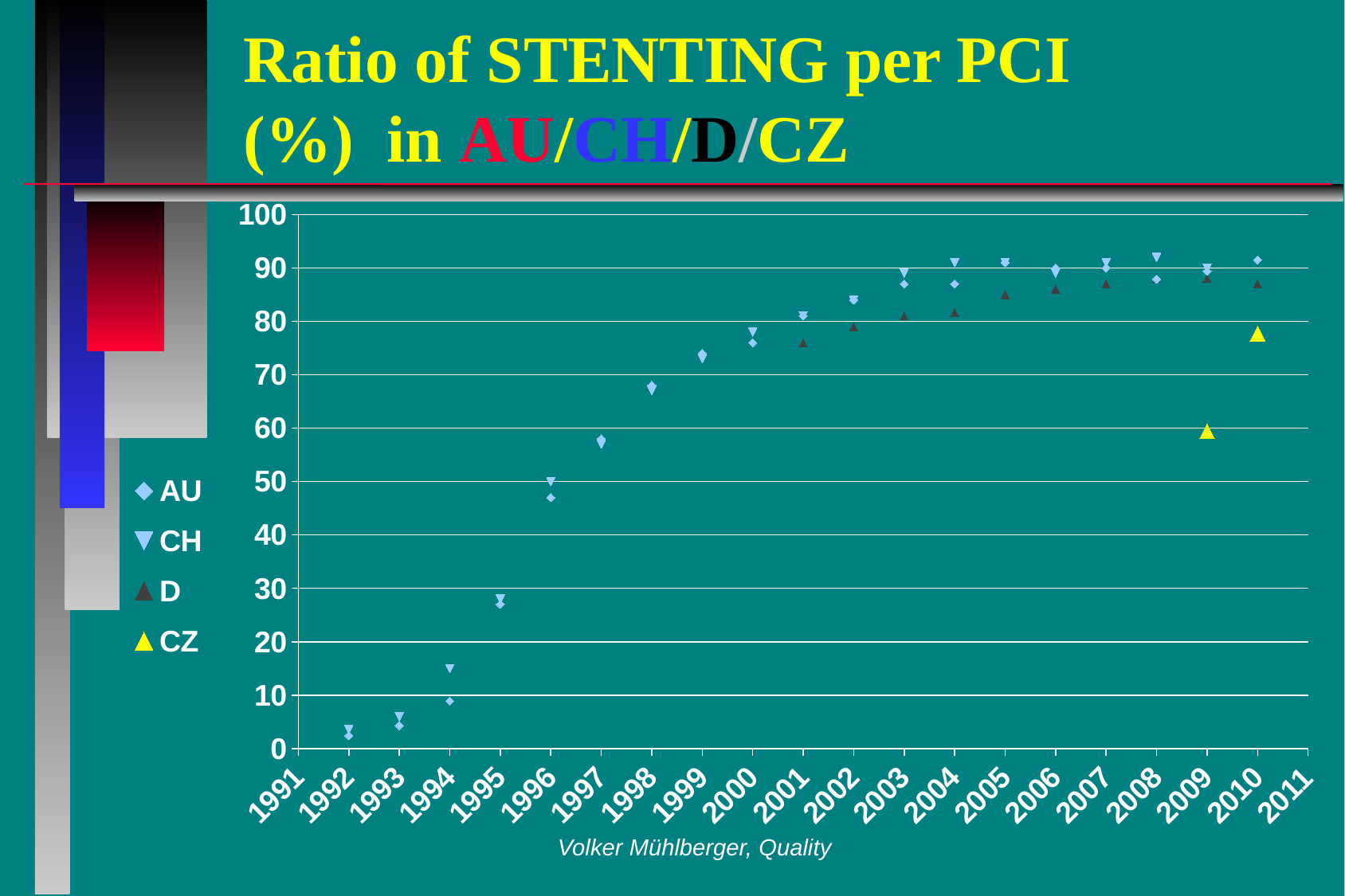
Does the AU series rise or fall from 1992 to 2005? rise Is the value for AU in 1998 greater or less than 70? less Which series is plotted with yellow triangle markers? CZ How many years are labelled on the x axis? 21 Is the value for CH in 1994 greater or less than 20? less Is the value for CZ in 2010 greater or less than 70? greater How many data points are plotted for the CZ series? 2 What kind of chart is shown on the slide? scatter chart How many series does the legend list? 4 Which series are listed in the legend? AU, CH, D, CZ